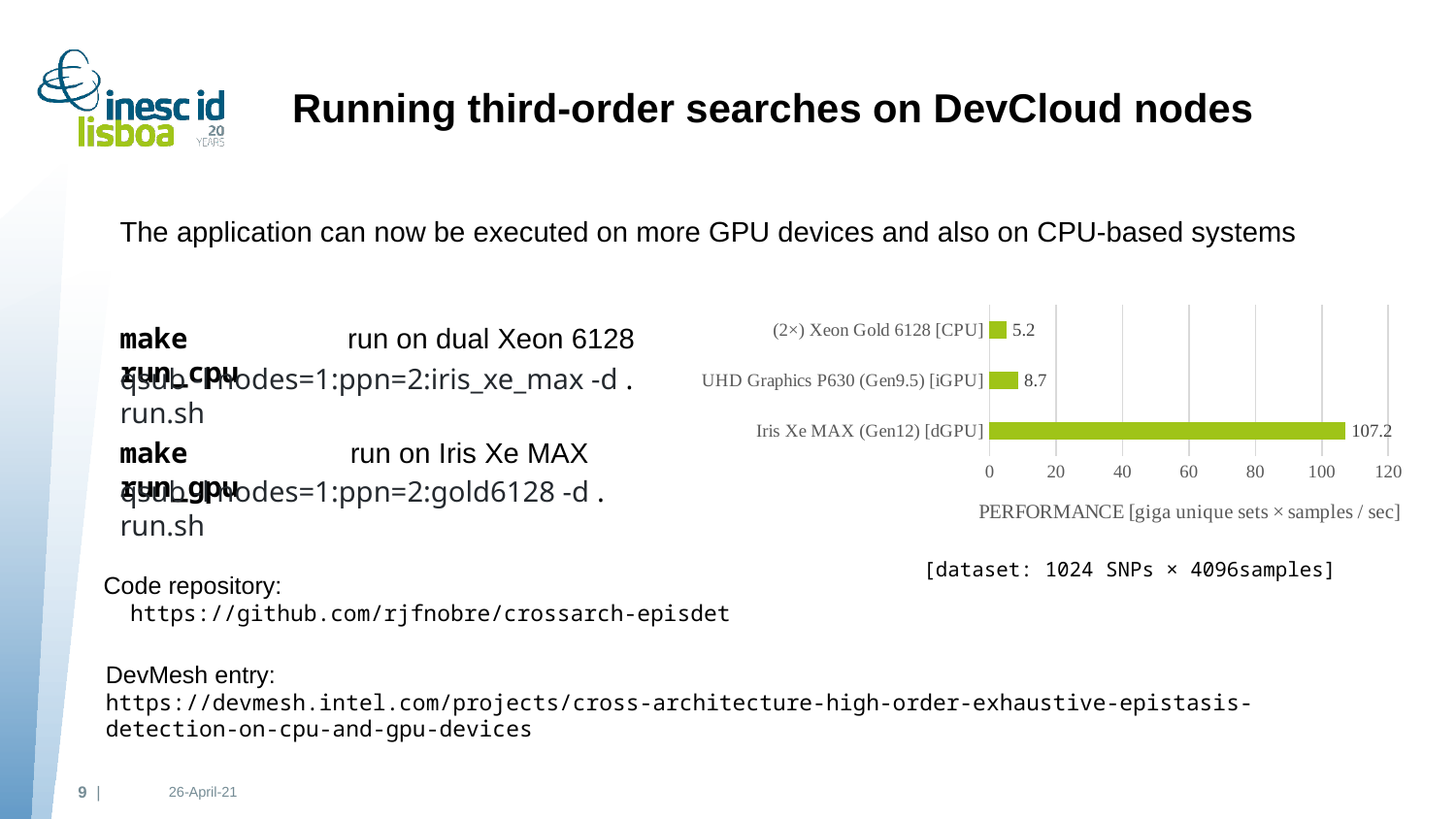
Which device has the lowest performance value? (2×) Xeon Gold 6128 [CPU] What is the performance value for UHD Graphics P630 (Gen9.5) [iGPU]? 8.7 How many devices are shown in the chart? 3 What is the performance value for Iris Xe MAX (Gen12) [dGPU]? 107.2 Which device has the highest performance value? Iris Xe MAX (Gen12) [dGPU] What is the difference between the performance of UHD Graphics P630 (Gen9.5) [iGPU] and (2×) Xeon Gold 6128 [CPU]? 3.5 Which has a larger performance value, UHD Graphics P630 (Gen9.5) [iGPU] or (2×) Xeon Gold 6128 [CPU]? UHD Graphics P630 (Gen9.5) [iGPU] What is the difference between the performance of Iris Xe MAX (Gen12) [dGPU] and UHD Graphics P630 (Gen9.5) [iGPU]? 98.5 What is the performance value for (2×) Xeon Gold 6128 [CPU]? 5.2 Is the value for Iris Xe MAX (Gen12) [dGPU] greater or less than 100? greater What is the label of the horizontal axis of the chart? PERFORMANCE [giga unique sets × samples / sec] What kind of chart is shown on the slide? bar chart